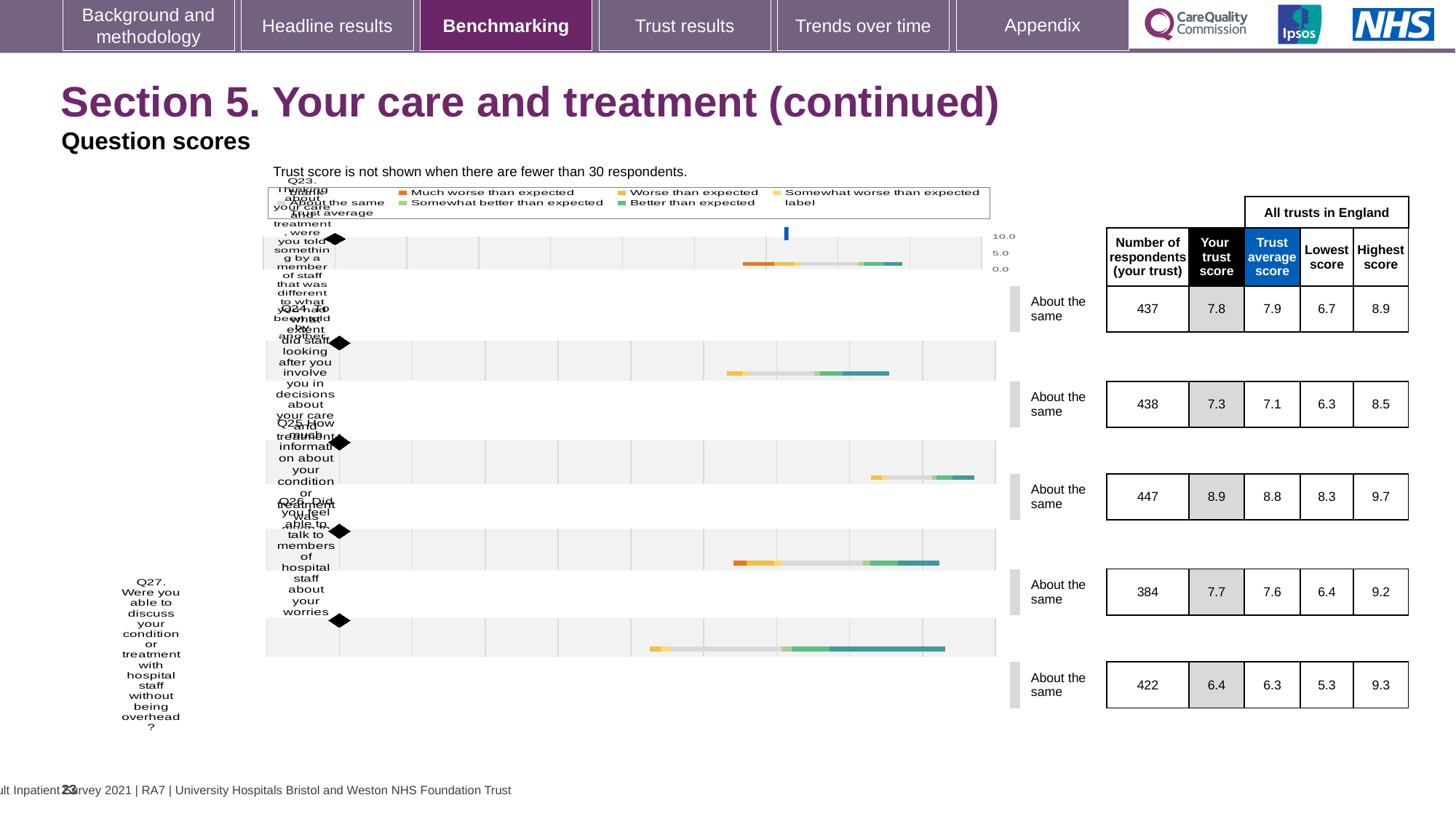
What is the 'Lowest score' across all trusts in England for Q23? 6.7 How many survey questions (rows) are shown in the benchmarking chart? 5 Which question has the lowest 'Your trust score' in the table? Q27 What is the difference between 'Your trust score' and the 'Trust average score' for Q24? 0.2 What benchmark category label is shown next to each of the five questions in the chart? About the same How many respondents from your trust answered Q25 (how much information about your condition or treatment was given)? 447 Which question has the highest 'Your trust score' in the table? Q25 What is the difference between the highest and lowest scores across all trusts in England for Q27? 4.0 What is the 'Highest score' across all trusts in England for Q27? 9.3 What kind of chart is used to show the benchmarking results for Q23 to Q27? bar chart For Q26, which is larger: 'Your trust score' or the 'Trust average score'? Your trust score What is the 'Your trust score' for Q27 (discussing your condition or treatment without being overheard)? 6.4